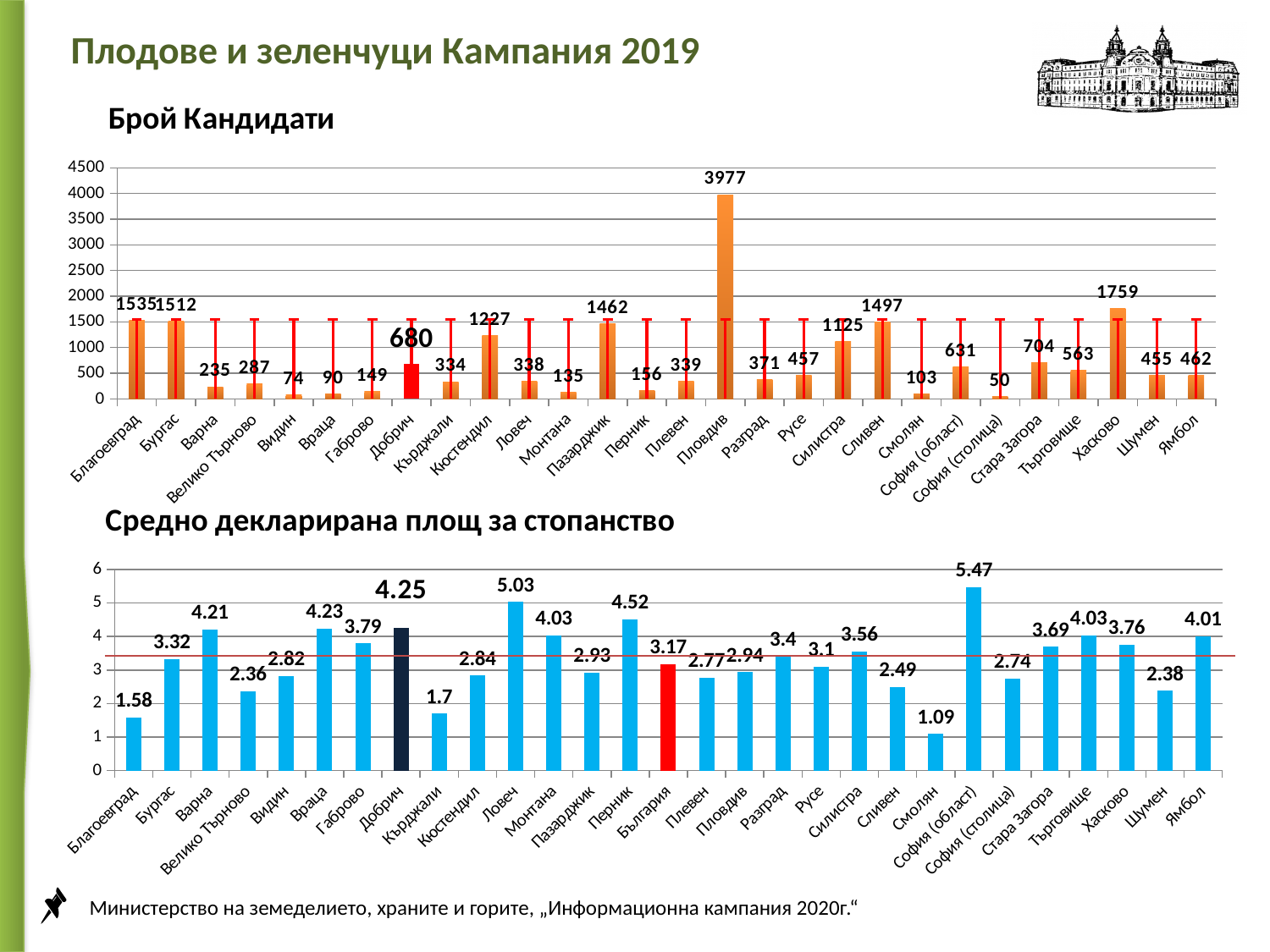
In the "Средно декларирана площ за стопанство" chart, what is the value for България? 3.17 In the "Брой Кандидати" chart, what is the difference between Хасково and Кюстендил? 532 In the "Брой Кандидати" chart, which category has the lowest value? София (столица) In the "Брой Кандидати" chart, what is the value for Стара Загора? 704 How many categories are shown in the "Средно декларирана площ за стопанство" chart? 29 In the "Средно декларирана площ за стопанство" chart, which category has the highest value? София (област) In the "Брой Кандидати" chart, what is the value for Добрич? 680 What type of chart is the "Средно декларирана площ за стопанство" chart? bar chart In the "Брой Кандидати" chart, which is larger, Благоевград or Бургас? Благоевград In the "Средно декларирана площ за стопанство" chart, what is the difference between Ловеч and Кърджали? 3.33 In the "Средно декларирана площ за стопанство" chart, which category has the lowest value? Смолян In the "Брой Кандидати" chart, what is the value for Пловдив? 3977